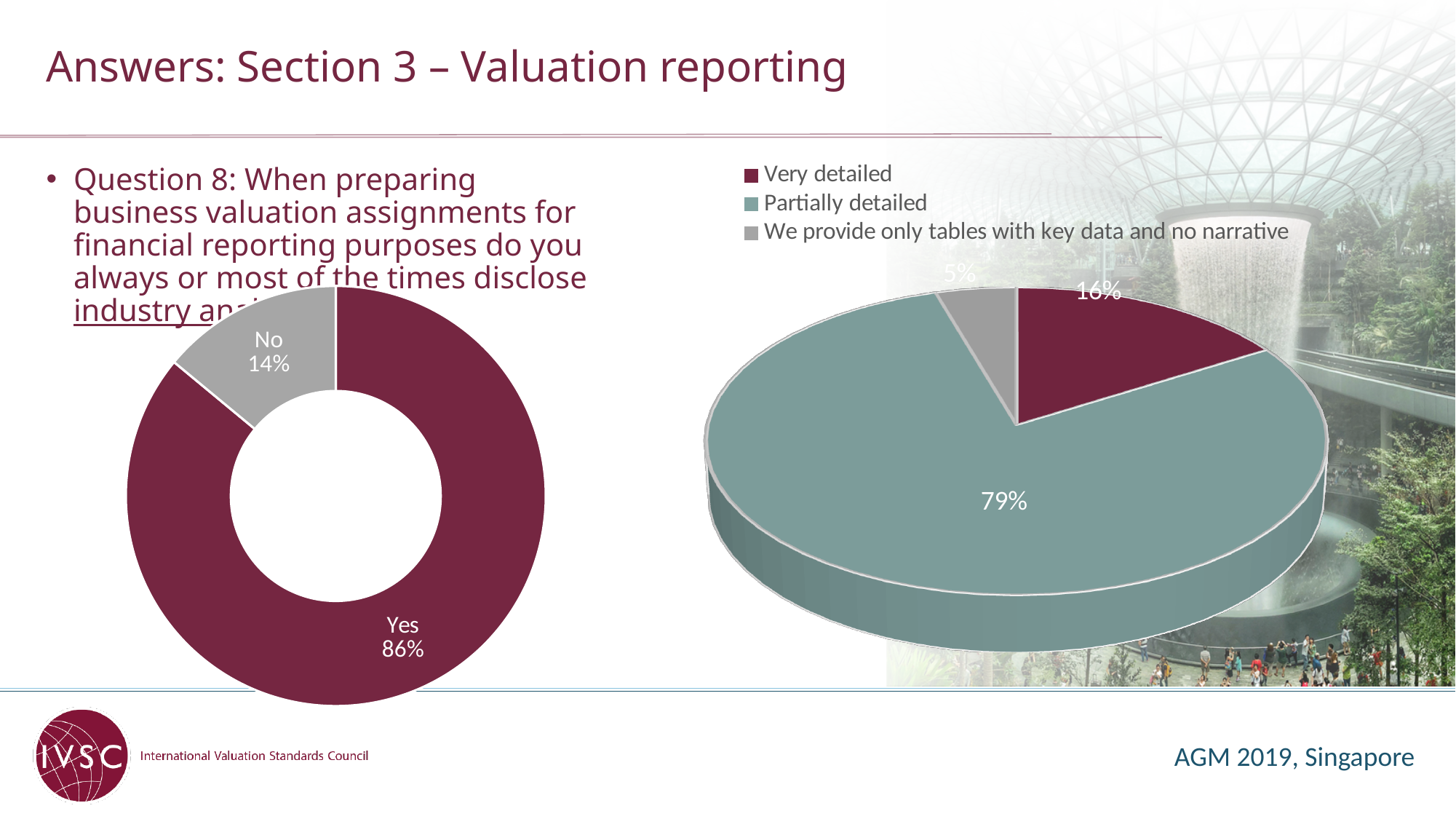
In the pie chart on the right, which category has the largest share? Partially detailed In the doughnut chart on the left, what percentage answered No? 14% How many categories does the doughnut chart on the left show? 2 In the pie chart on the right, what percentage is Very detailed? 16% In the pie chart on the right, what percentage is 'We provide only tables with key data and no narrative'? 5% In the pie chart on the right, what percentage is Partially detailed? 79% How many entries does the legend of the pie chart on the right list? 3 In the doughnut chart on the left, what is the difference in percentage points between Yes and No? 72 In the pie chart on the right, which category has the smallest share? We provide only tables with key data and no narrative In the doughnut chart on the left, which answer has the larger share? Yes In the doughnut chart on the left, what percentage answered Yes? 86% In the pie chart on the right, what colour is the Very detailed slice? Dark red